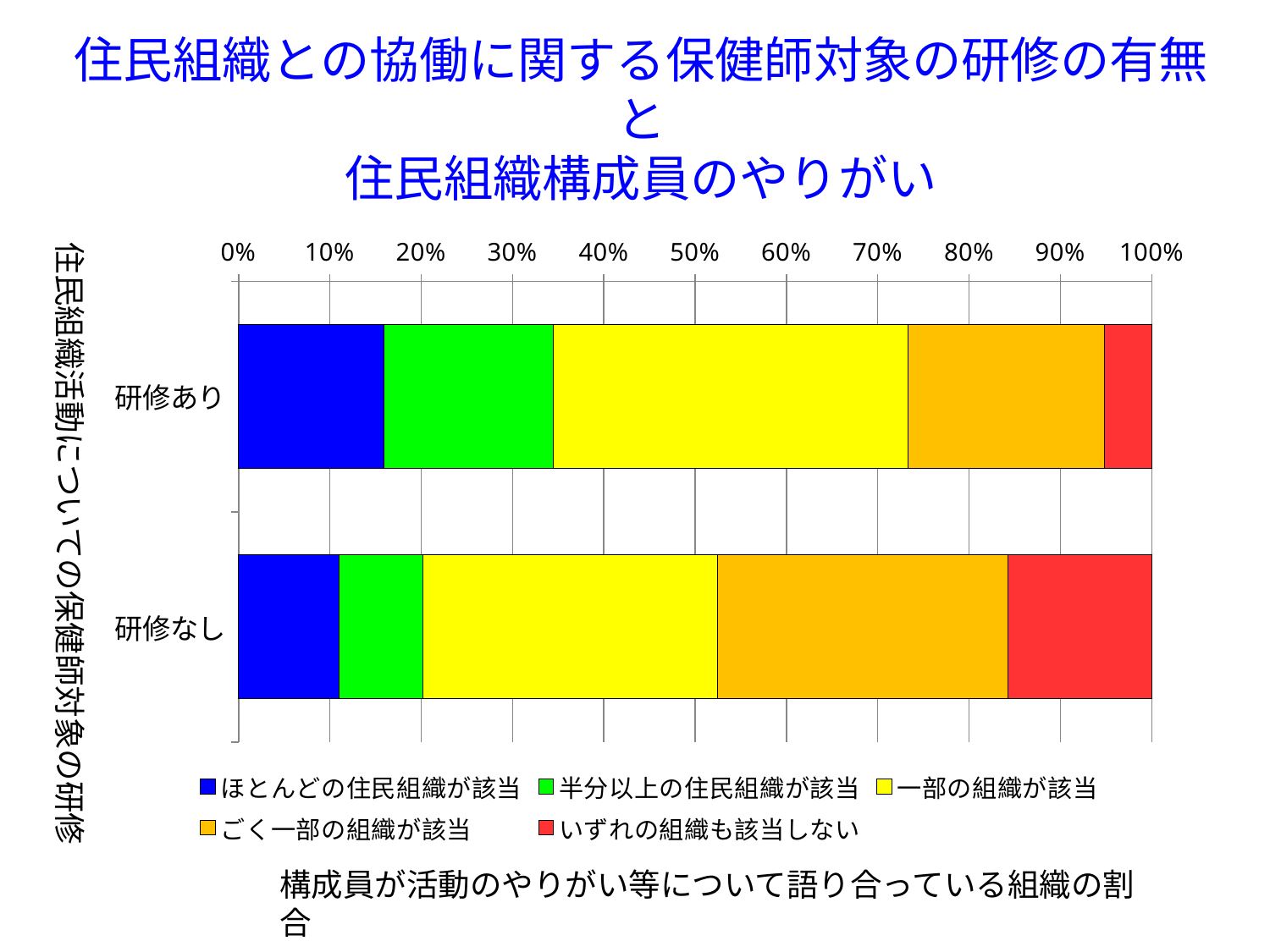
Which category has the larger green segment (半分以上の住民組織が該当), 研修あり or 研修なし? 研修あり Which category has the larger blue segment (ほとんどの住民組織が該当), 研修あり or 研修なし? 研修あり Is the share of ほとんどの住民組織が該当 for 研修あり greater or less than 10%? greater How many series does the legend list? 5 Is the share of いずれの組織も該当しない for 研修あり greater or less than 10%? less What colour represents いずれの組織も該当しない in the legend? red Which segment is the smallest in the 研修あり bar? いずれの組織も該当しない Which category has the larger orange segment (ごく一部の組織が該当), 研修あり or 研修なし? 研修なし How many categories (bars) are plotted on the chart? 2 What kind of chart is shown on the slide? stacked bar chart Which segment is the largest in the 研修あり bar? 一部の組織が該当